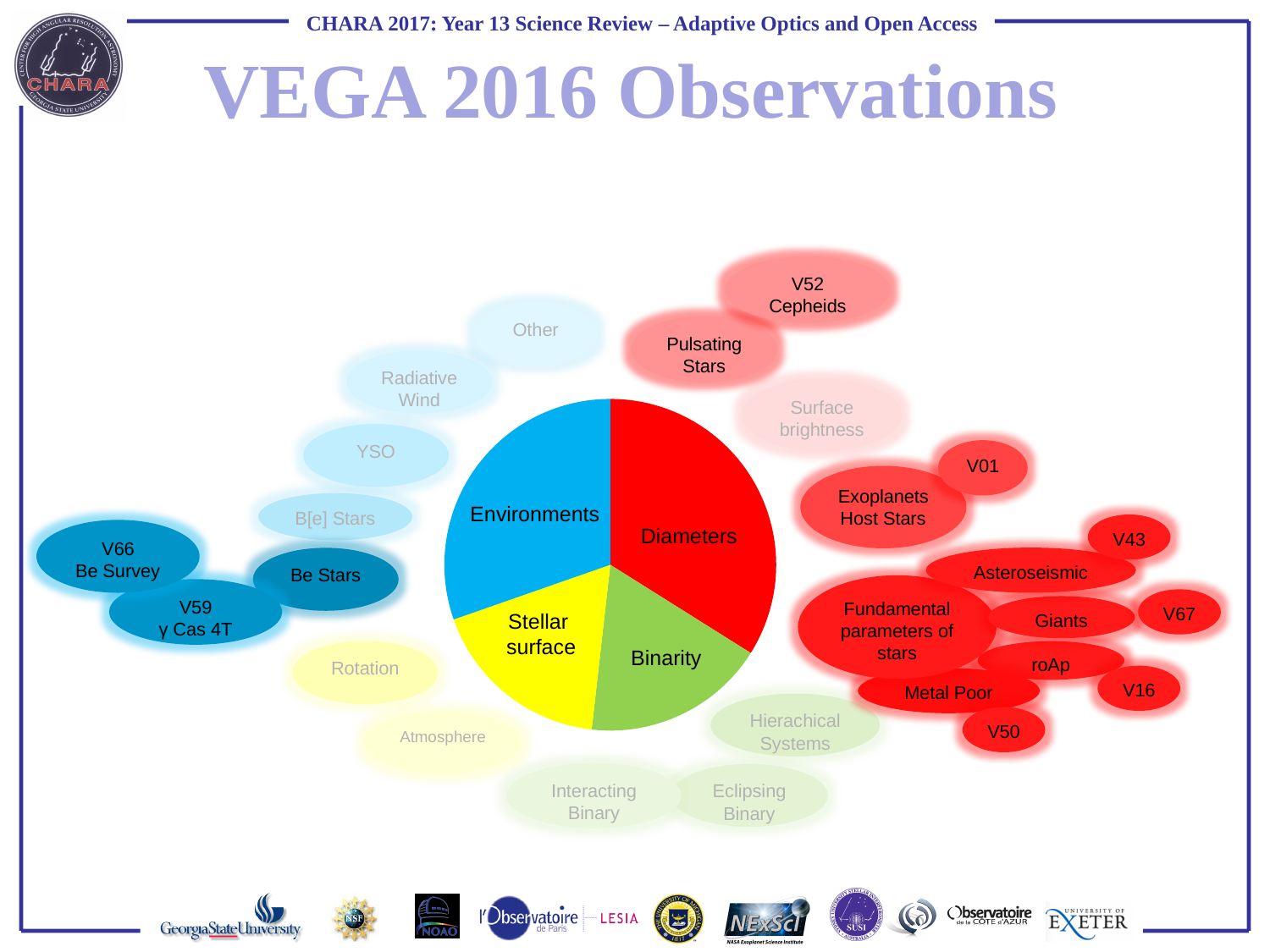
Which slice of the pie chart is the largest? Diameters Which slice is larger in the pie chart, Environments or Stellar surface? Environments Which slice is larger in the pie chart, Diameters or Binarity? Diameters Which slice is larger in the pie chart, Environments or Binarity? Environments How many slices does the pie chart have? 4 Which slice of the pie chart is coloured yellow? Stellar surface What colour is the Diameters slice of the pie chart? red What kind of chart is shown on the slide? pie chart